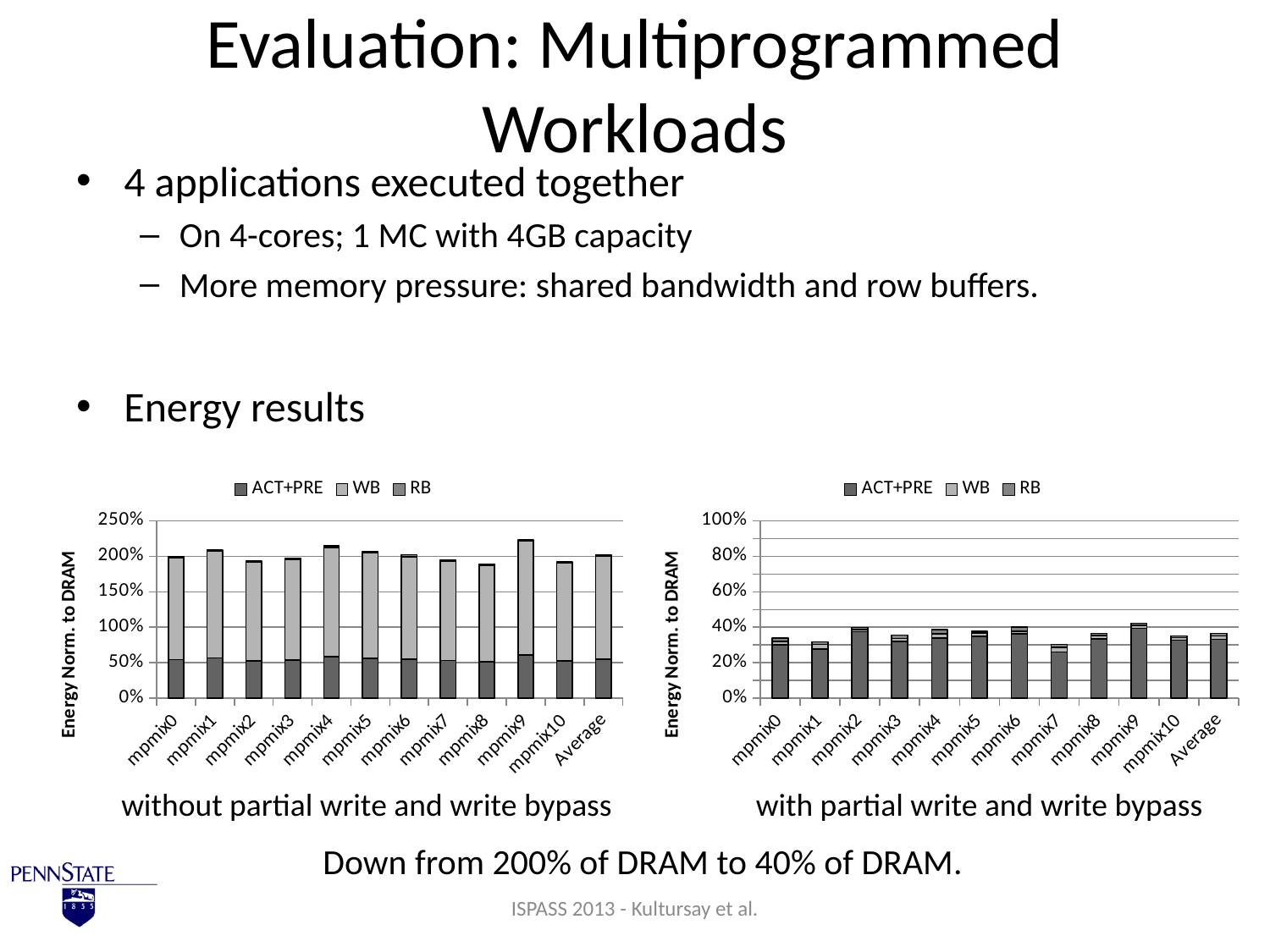
In the right chart ('with partial write and write bypass'), which has the larger total bar, mpmix9 or mpmix7? mpmix9 What is the y-axis label of the right chart ('with partial write and write bypass')? Energy Norm. to DRAM How many series does the legend of the right chart ('with partial write and write bypass') list? 3 In the right chart ('with partial write and write bypass'), which category has the highest total bar? mpmix9 In the left chart ('without partial write and write bypass'), is the total value for mpmix8 greater or less than 200%? less How many categories are shown on the x axis of the left chart ('without partial write and write bypass')? 12 In the right chart ('with partial write and write bypass'), is the total value for mpmix7 greater or less than 40%? less In the left chart ('without partial write and write bypass'), which has the larger total bar, mpmix9 or mpmix8? mpmix9 What kind of chart is the left chart titled 'without partial write and write bypass'? stacked bar chart In the left chart ('without partial write and write bypass'), which category has the highest total bar? mpmix9 In the left chart ('without partial write and write bypass'), is the total value for mpmix9 greater or less than 200%? greater